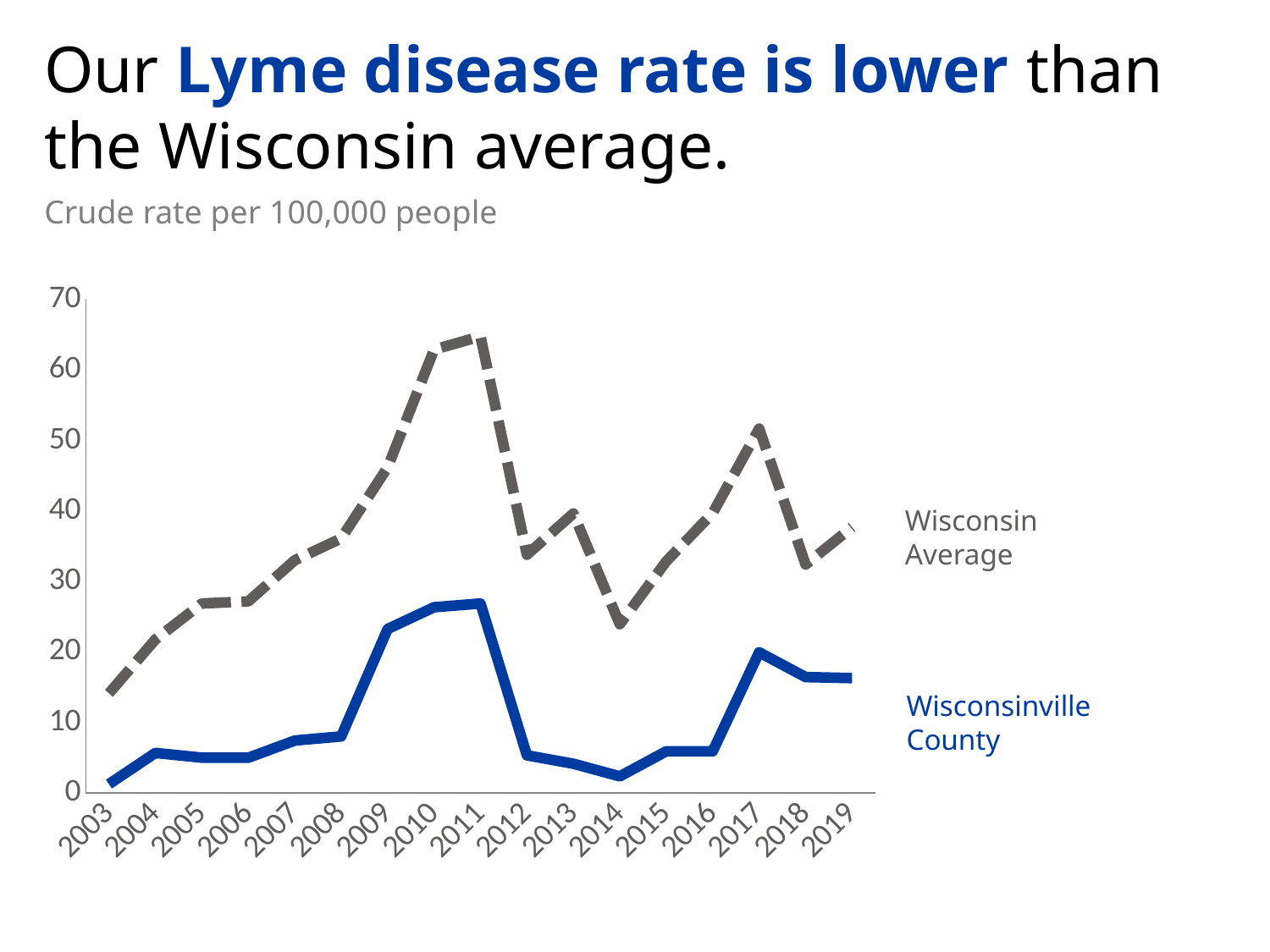
How many series does the chart show? 2 What unit does the subtitle say the rates are measured in? Crude rate per 100,000 people Is the Wisconsinville County value for 2017 greater or less than 10? greater Does the Wisconsin Average rise or fall from 2003 to 2011? rise In which year is the Wisconsin Average at its lowest? 2003 How many years are plotted along the x axis? 17 In which year is the Wisconsin Average at its highest? 2011 Is the Wisconsinville County value for 2011 greater or less than 30? less Is the Wisconsin Average value for 2017 greater or less than 40? greater In 2011, which series has the larger value, Wisconsin Average or Wisconsinville County? Wisconsin Average What kind of chart is shown on the slide? line chart